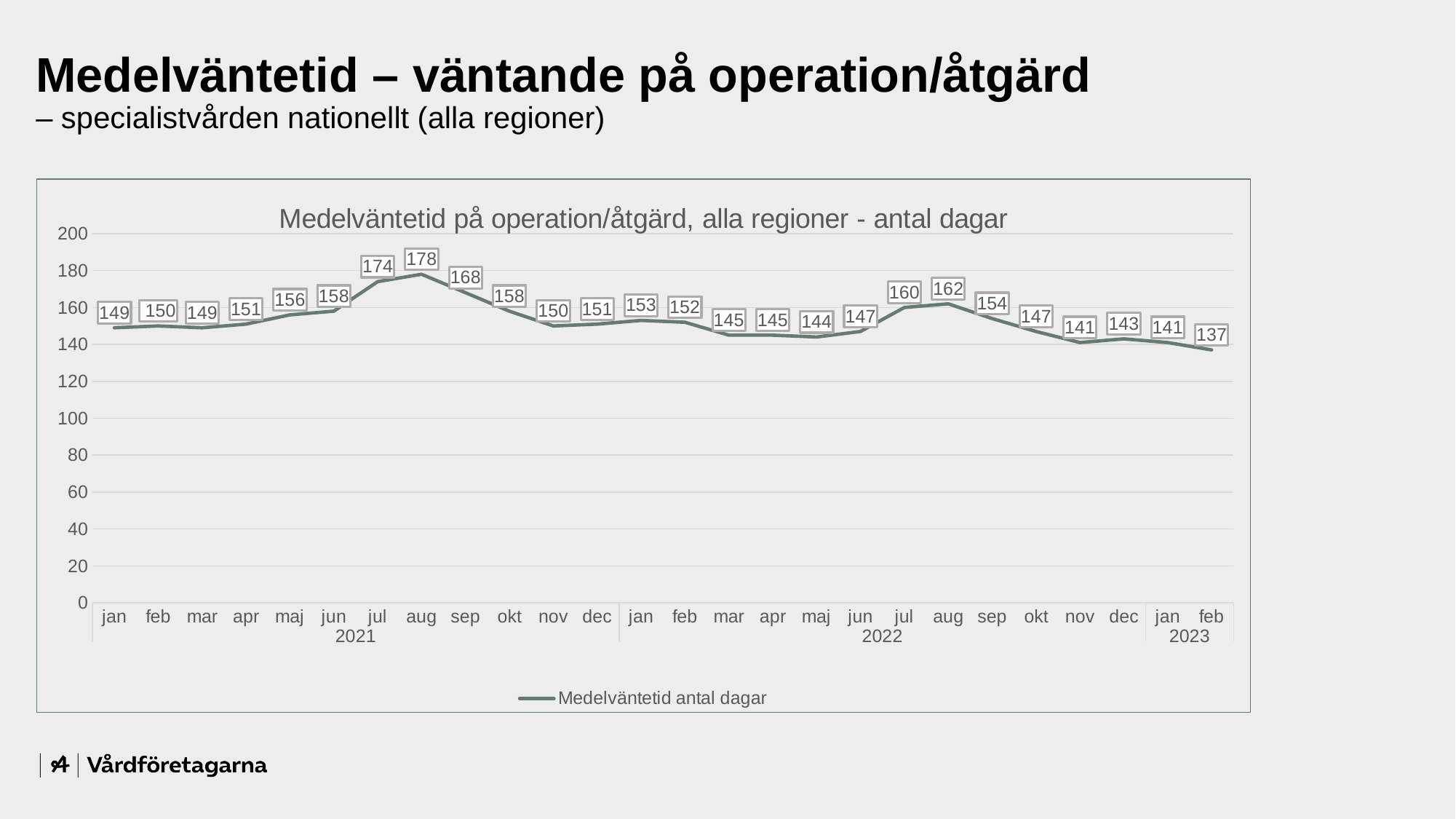
What is the difference between the values for jan 2021 and jan 2023? 8 What is the value for aug 2021? 178 What is the difference between the values for aug 2021 and aug 2022? 16 Which is larger, the value for jul 2021 or the value for jul 2022? jul 2021 What kind of chart is shown? line chart Which month has the lowest value? feb 2023 What is the value for feb 2023? 137 What is the title of the chart? Medelväntetid på operation/åtgärd, alla regioner - antal dagar What is the value for maj 2022? 144 Which month has the highest value? aug 2021 How many series does the legend list? 1 How many data points are plotted on the line? 26